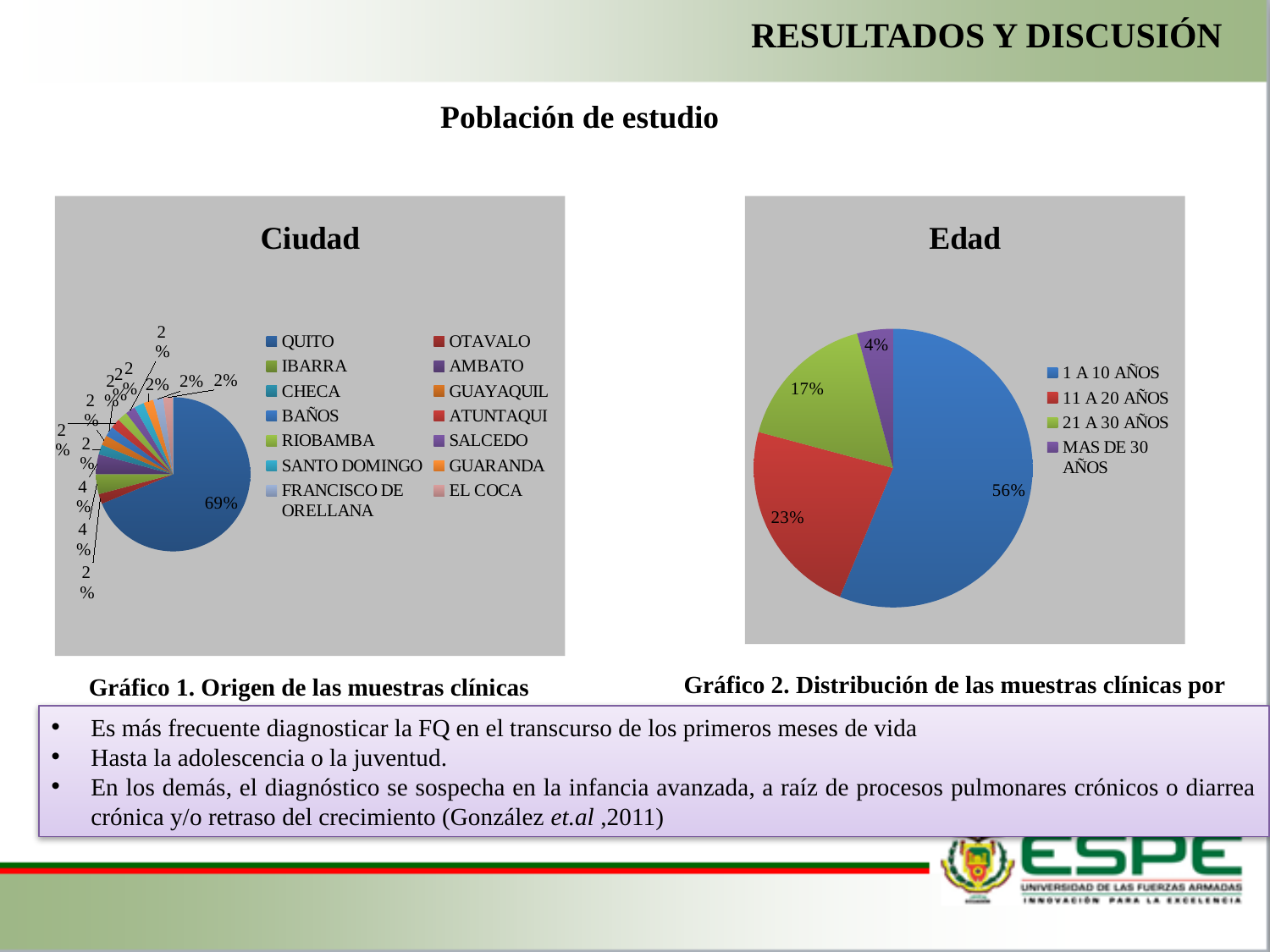
What type of chart is the 'Edad' chart? pie chart In the 'Edad' chart, what share corresponds to 21 A 30 AÑOS? 17% In the 'Ciudad' chart, how many cities does the legend list? 14 In the 'Edad' chart, what share corresponds to 11 A 20 AÑOS? 23% In the 'Edad' chart, which age group has the smallest share? MAS DE 30 AÑOS In the 'Edad' chart, which age group has the largest share? 1 A 10 AÑOS In the 'Edad' chart, what share corresponds to 1 A 10 AÑOS? 56% In the 'Ciudad' chart, what share corresponds to QUITO? 69% In the 'Edad' chart, what share corresponds to MAS DE 30 AÑOS? 4% In the 'Edad' chart, how many age groups are shown? 4 In the 'Edad' chart, what is the difference between the shares of 1 A 10 AÑOS and 11 A 20 AÑOS? 33% In the 'Ciudad' chart, which city has the largest share? QUITO